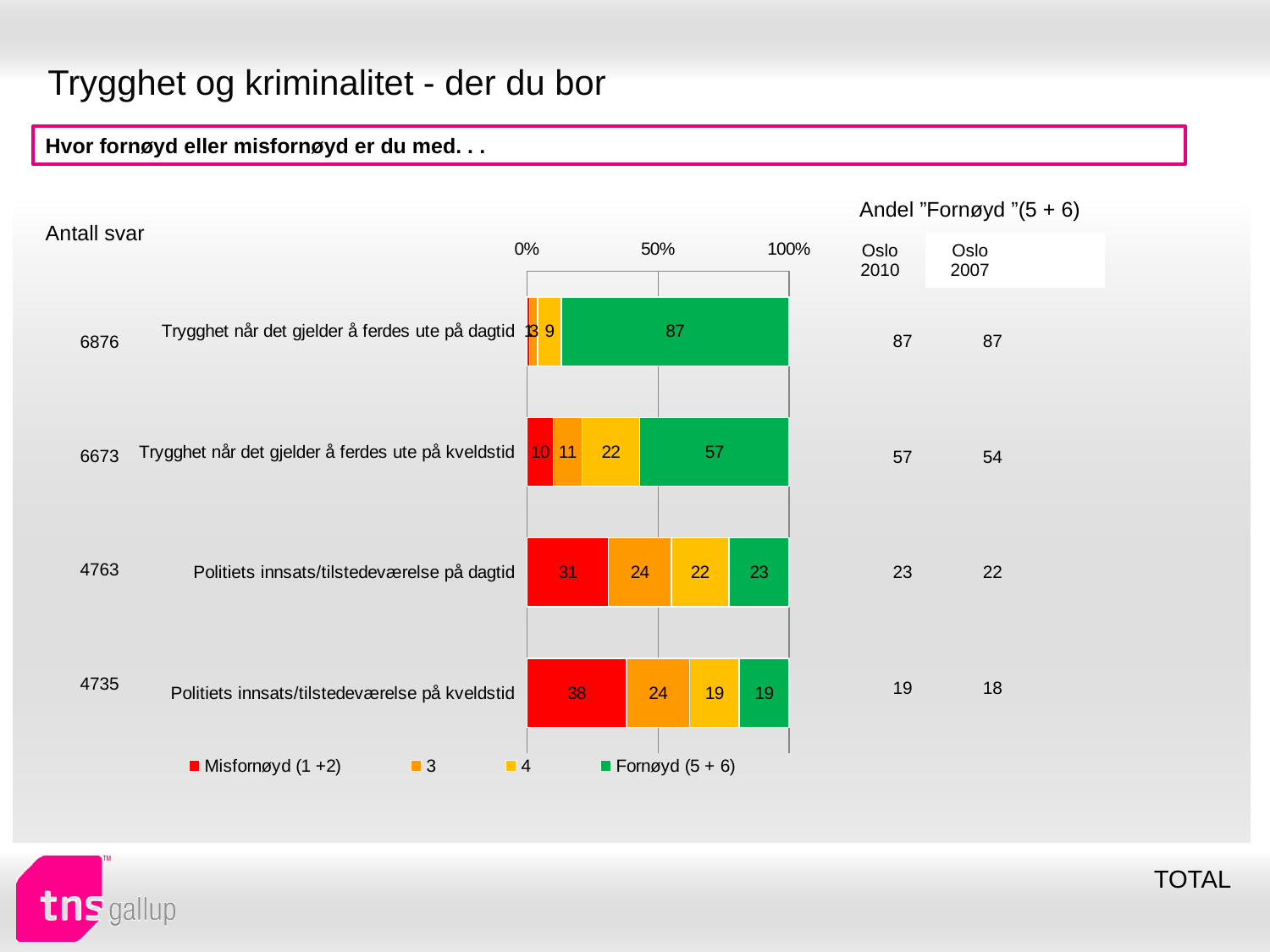
What is the '4' value for 'Trygghet når det gjelder å ferdes ute på kveldstid'? 22 What is the '3' value for 'Politiets innsats/tilstedeværelse på dagtid'? 24 What is the difference between the 'Misfornøyd (1 +2)' values for 'Politiets innsats/tilstedeværelse på kveldstid' and 'Politiets innsats/tilstedeværelse på dagtid'? 7 How many categories are plotted in the chart? 4 Which is larger: the 'Fornøyd (5 + 6)' value for 'Trygghet når det gjelder å ferdes ute på kveldstid' or for 'Politiets innsats/tilstedeværelse på dagtid'? Trygghet når det gjelder å ferdes ute på kveldstid Which category has the lowest 'Fornøyd (5 + 6)' value? Politiets innsats/tilstedeværelse på kveldstid Which category has the highest 'Fornøyd (5 + 6)' value? Trygghet når det gjelder å ferdes ute på dagtid What is the 'Fornøyd (5 + 6)' value for 'Trygghet når det gjelder å ferdes ute på dagtid'? 87 What type of chart is shown on the slide? stacked bar chart What is the 'Misfornøyd (1 +2)' value for 'Politiets innsats/tilstedeværelse på kveldstid'? 38 Which legend entry is shown in green? Fornøyd (5 + 6) How many series does the chart legend list? 4